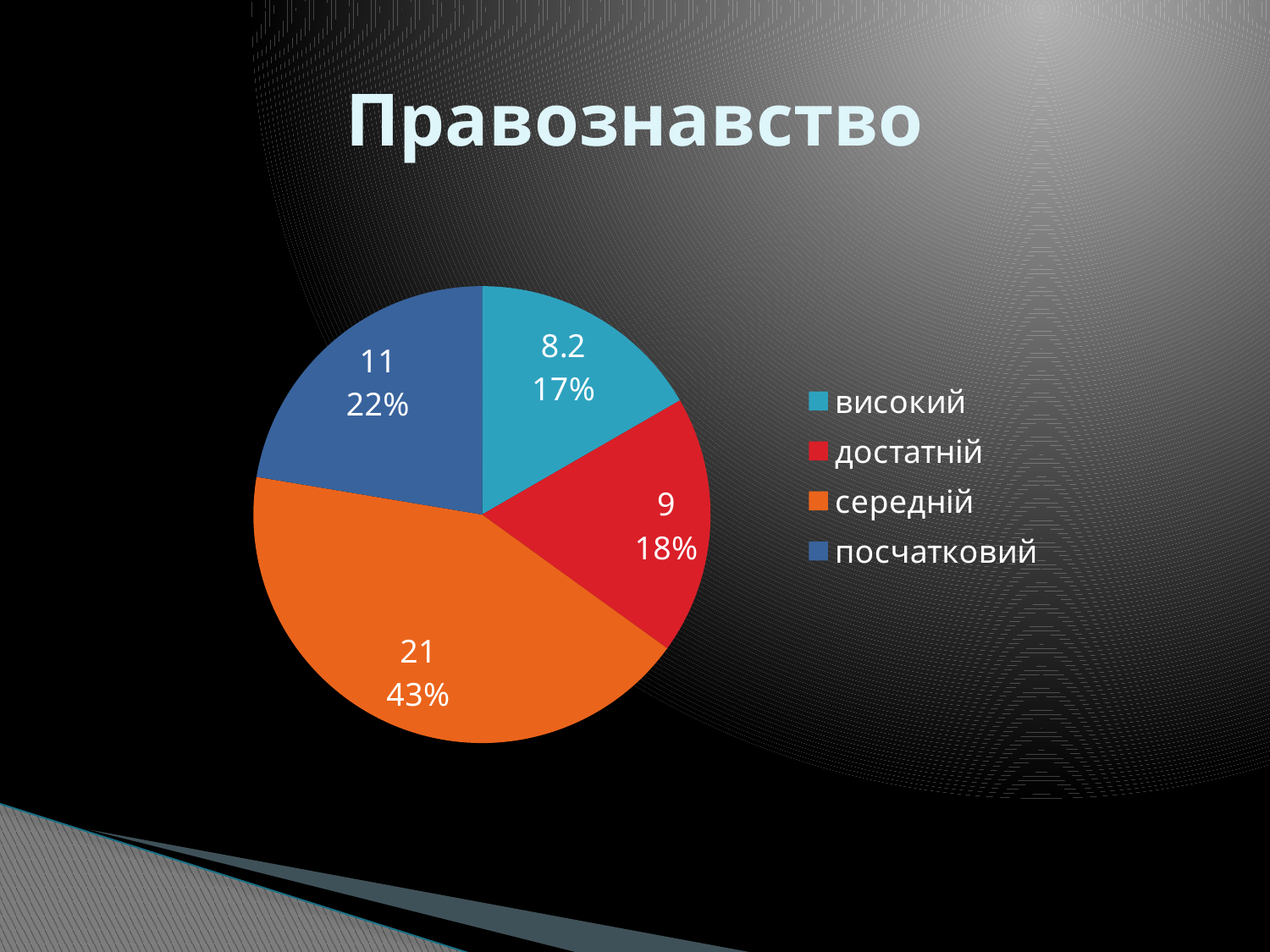
What is the difference between the values for середній and посчатковий? 10 What is the value for посчатковий? 11 Which category has the largest slice? середній What is the value for високий? 8.2 What is the value for середній? 21 What percentage share does достатній have? 18% What percentage share does середній have? 43% Which is larger, the value for достатній or the value for посчатковий? посчатковий What kind of chart is shown on the slide? pie chart Which category has the smallest slice? високий What is the title of the chart? Правознавство How many categories does the legend list? 4